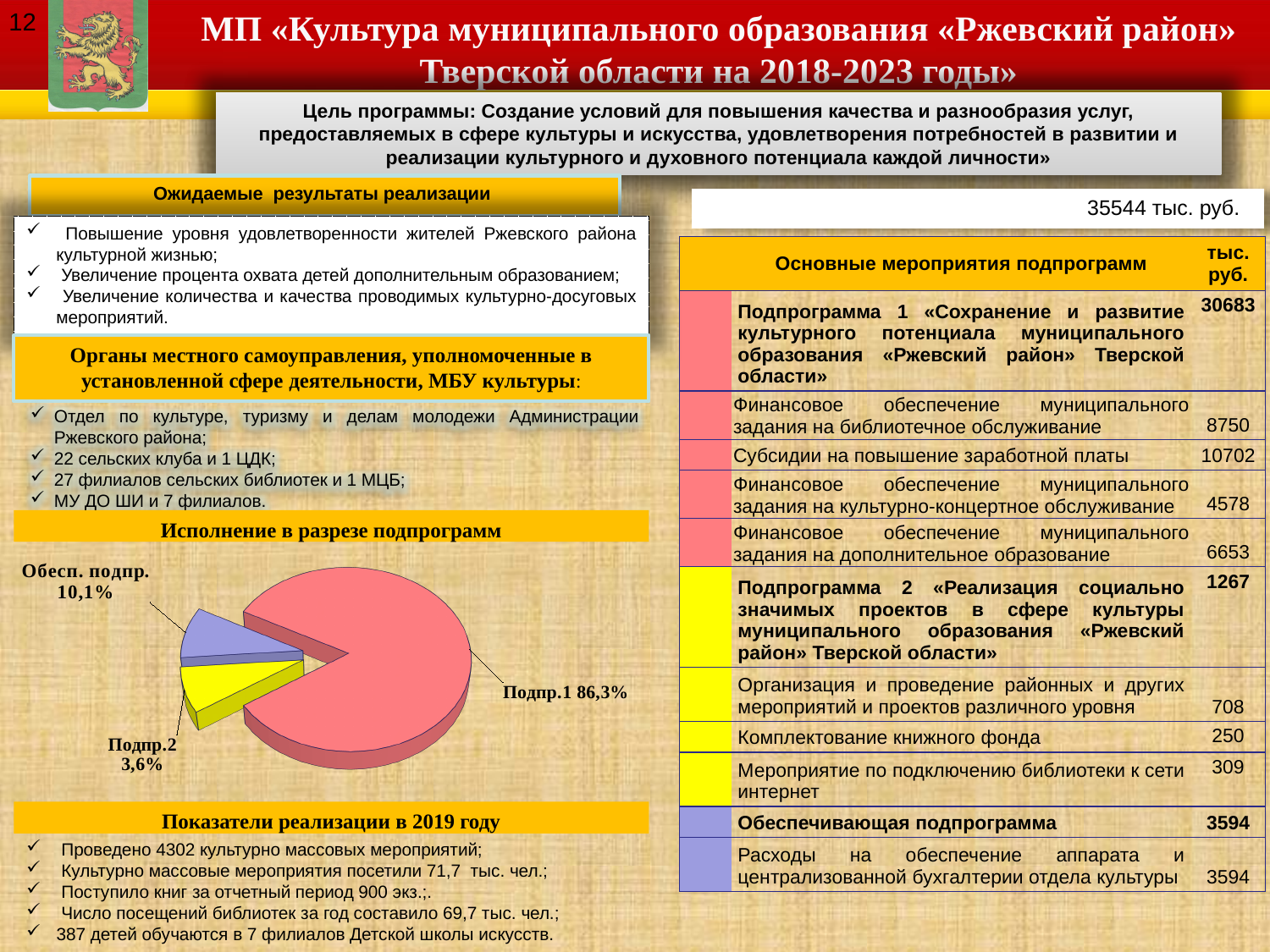
In the pie chart «Исполнение в разрезе подпрограмм», which is larger: Обесп. подпр. or Подпр.2? Обесп. подпр. In the pie chart «Исполнение в разрезе подпрограмм», how many slices are there? 3 In the pie chart «Исполнение в разрезе подпрограмм», what colour is the Подпр.2 slice? yellow In the pie chart «Исполнение в разрезе подпрограмм», what colour is the Подпр.1 slice? pink/red In the pie chart «Исполнение в разрезе подпрограмм», what is the difference in percentage points between Обесп. подпр. and Подпр.2? 6,5 What kind of chart is shown under the heading «Исполнение в разрезе подпрограмм»? pie chart In the pie chart «Исполнение в разрезе подпрограмм», what share does Подпр.1 have? 86,3% In the pie chart «Исполнение в разрезе подпрограмм», which slice is the largest? Подпр.1 In the pie chart «Исполнение в разрезе подпрограмм», what is the difference in percentage points between Подпр.1 and Обесп. подпр.? 76,2 In the pie chart «Исполнение в разрезе подпрограмм», what share does Обесп. подпр. have? 10,1% In the pie chart «Исполнение в разрезе подпрограмм», what share does Подпр.2 have? 3,6% In the pie chart «Исполнение в разрезе подпрограмм», which slice is the smallest? Подпр.2